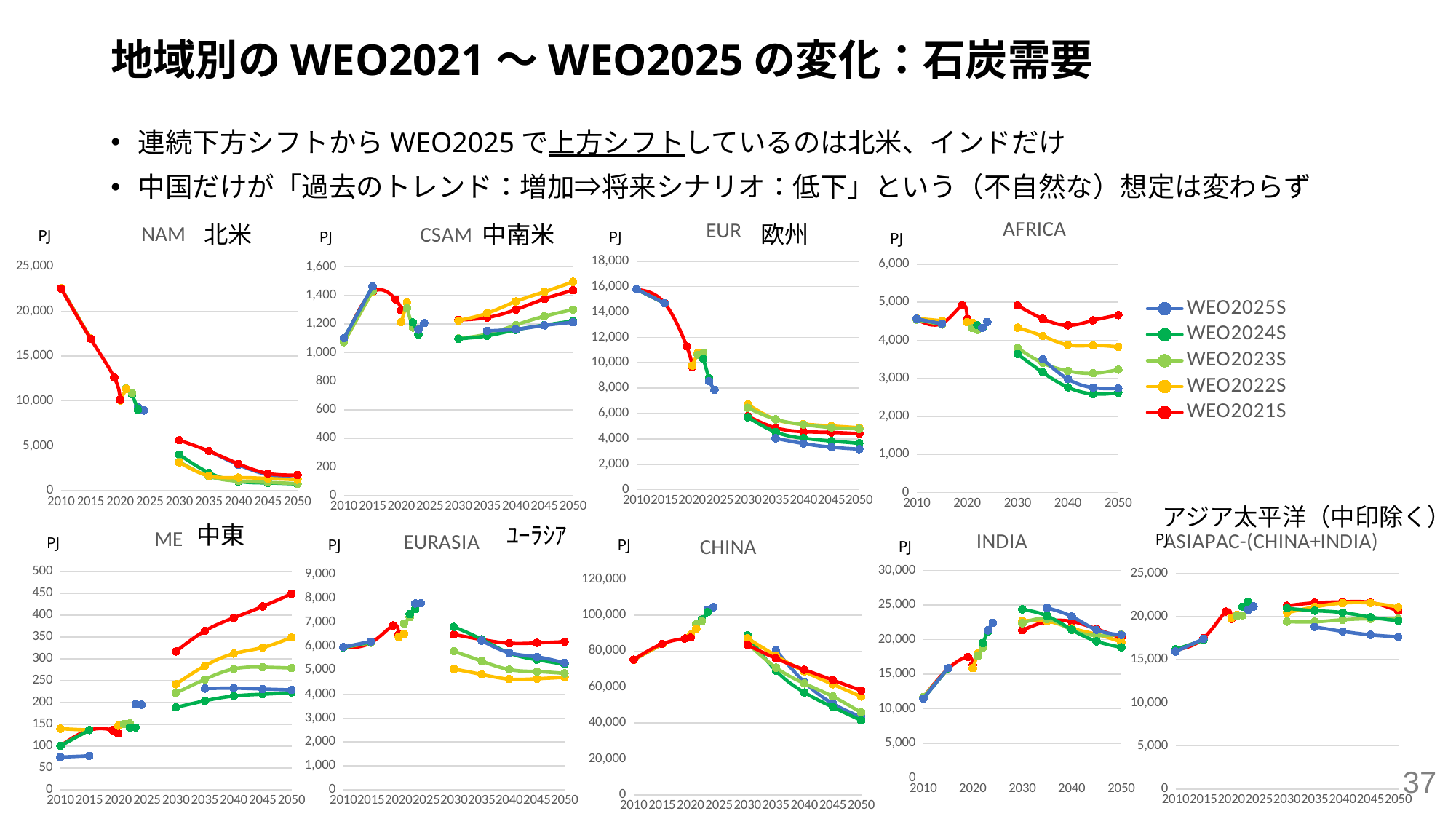
In the ME chart, does the WEO2021S line rise or fall from 2030 to 2050? rise In the ASIAPAC-(CHINA+INDIA) chart, is the WEO2025S value for 2050 greater or less than 20,000? less How many series does the legend list? 5 In the EUR chart, is the WEO2025S value for 2050 greater or less than 4,000? less In the AFRICA chart, is the WEO2021S value for 2050 greater or less than 4,000? greater In the NAM chart, does the WEO2021S line rise or fall from 2010 to 2050? fall What kind of chart is the NAM chart? line chart How many charts are on the slide? 9 In the ME chart, which is larger in 2050, WEO2021S or WEO2025S? WEO2021S